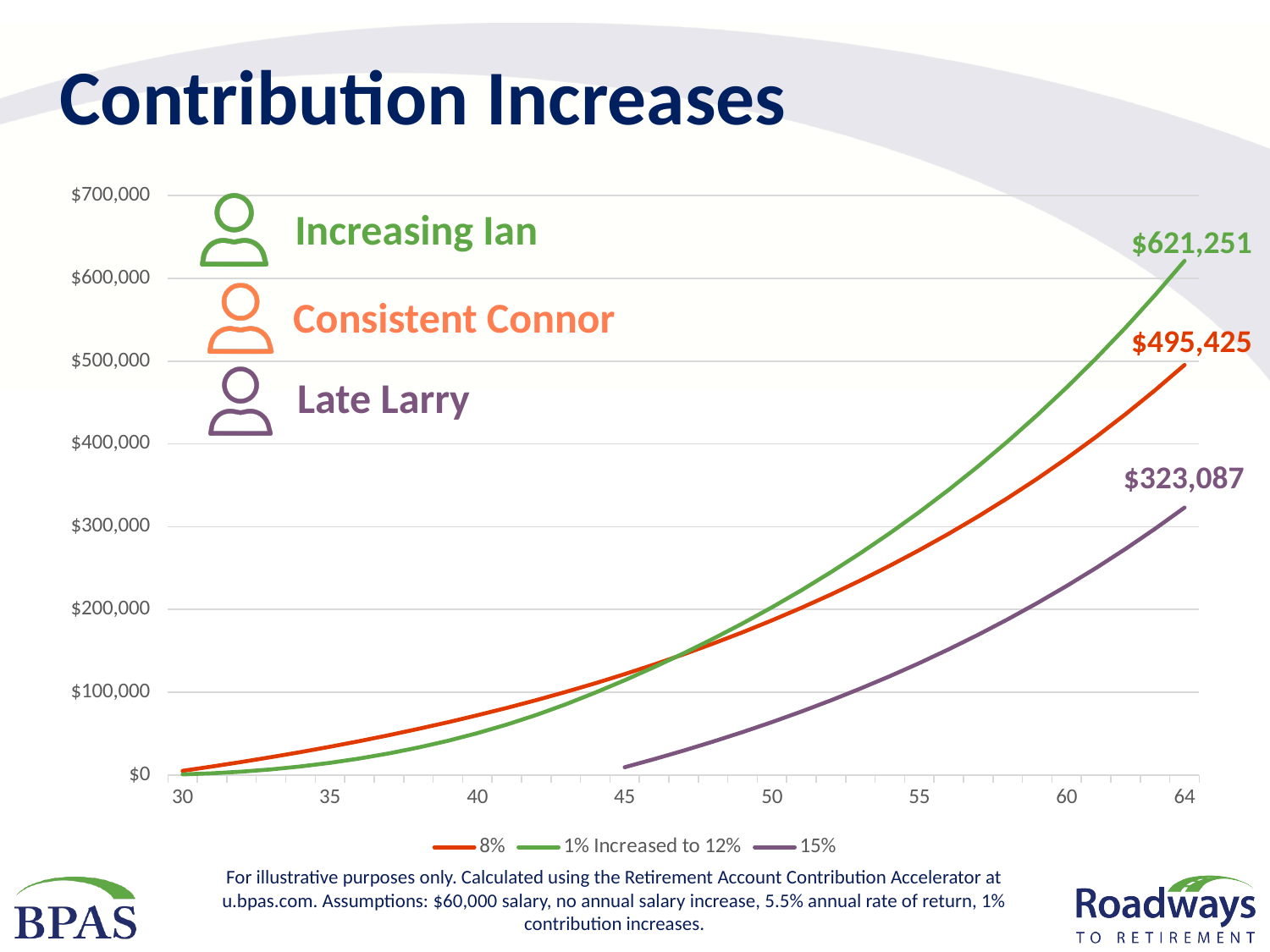
Which series reaches the highest value at age 64? 1% Increased to 12% What is the final value shown for the 8% line at age 64? $495,425 What kind of chart is shown on the slide? line chart Which series has the lowest value at age 64? 15% What is the final value shown for the 15% line at age 64? $323,087 How many series does the legend list? 3 Is the value of the 15% line at age 55 greater or less than $200,000? less What is the final value shown for the 1% Increased to 12% line at age 64? $621,251 What is the difference between the final values of the 8% line and the 15% line? $172,338 What is the title of the slide containing the chart? Contribution Increases What is the difference between the final values of the 1% Increased to 12% line and the 8% line? $125,826 At age 64, which is larger: the value of the 8% line or the 15% line? 8%